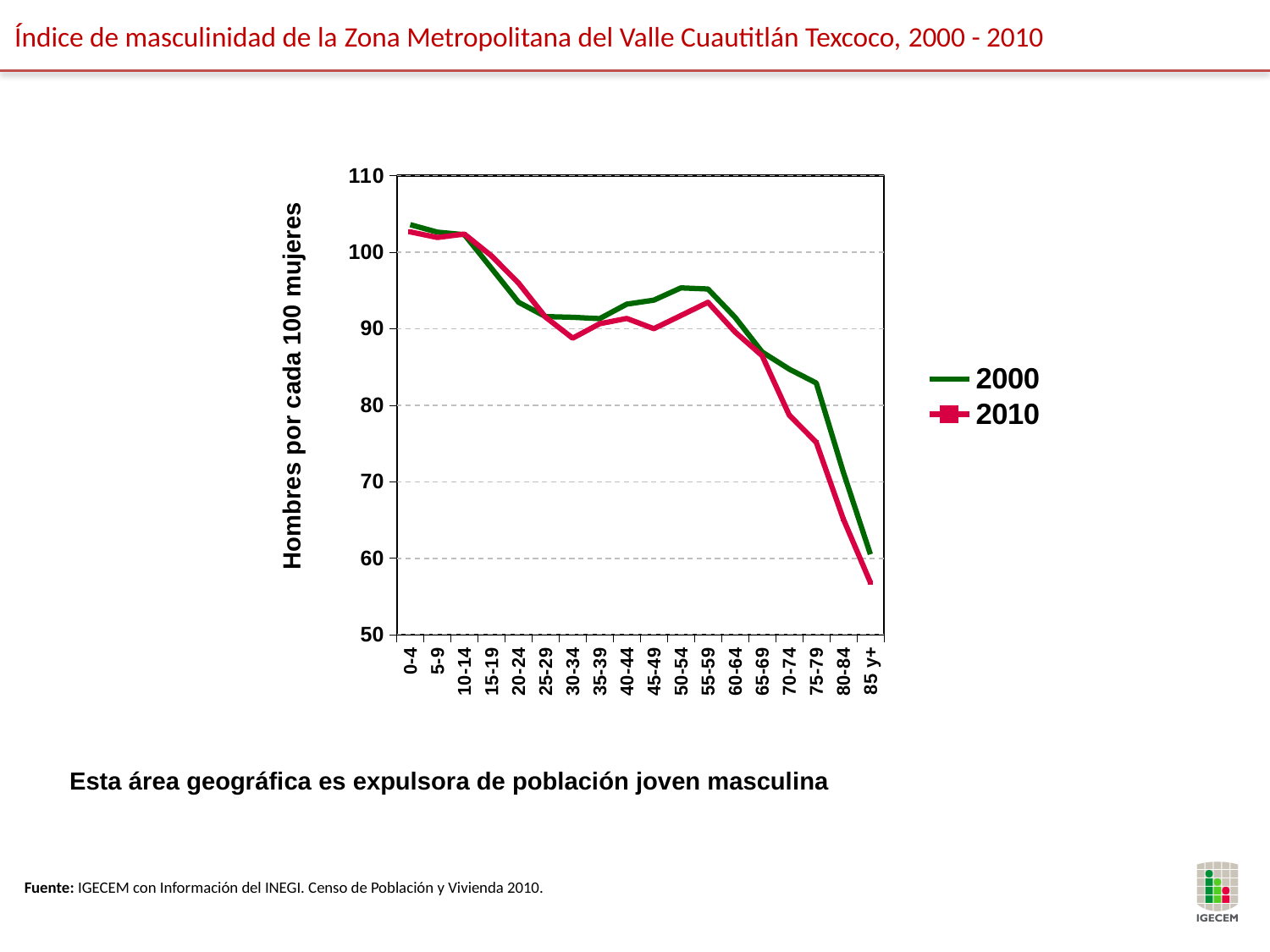
How many series does the legend list? 2 Is the value for 2000 at 50-54 greater or less than 90? greater For which age group is the 2010 series at its lowest value? 85 y+ At the 75-79 age group, which series has the larger value, 2000 or 2010? 2000 Is the value for 2000 at 0-4 greater or less than 100? greater Is the value for 2010 at 75-79 greater or less than 80? less Overall, do the values rise or fall as age increases along the x axis? fall What kind of chart is shown on the slide? line chart For which age group is the 2000 series at its lowest value? 85 y+ How many age groups are shown along the x axis? 18 What is the label of the vertical axis? Hombres por cada 100 mujeres